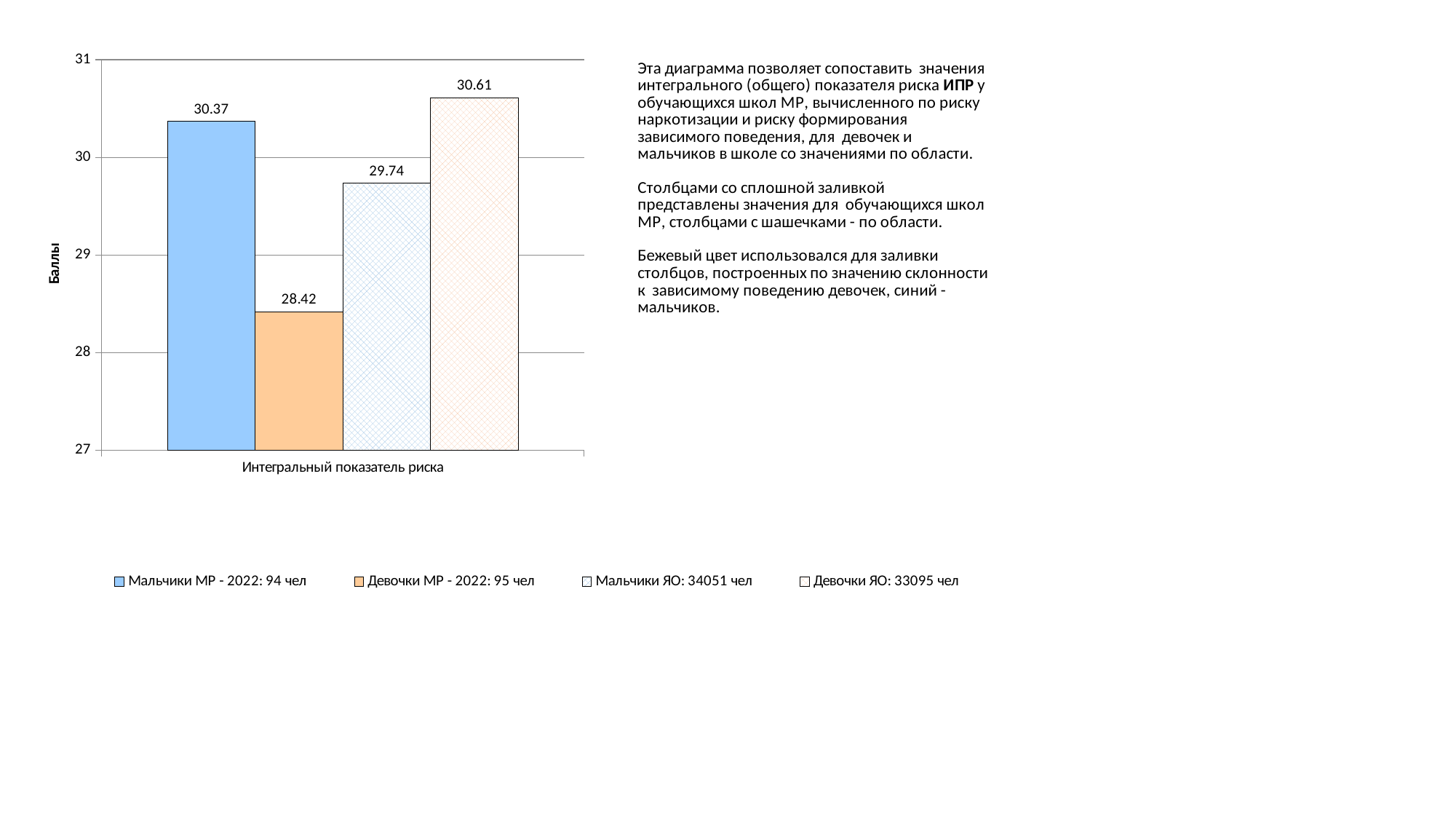
What kind of chart is shown on the slide? bar chart Which series has the highest value? Девочки ЯО: 33095 чел How many series does the legend list? 4 What is the value for Девочки ЯО: 33095 чел? 30.61 What is the value for Девочки МР - 2022: 95 чел? 28.42 Is the value for Девочки МР - 2022: 95 чел greater or less than 29? less What is the difference between the values for Девочки ЯО: 33095 чел and Девочки МР - 2022: 95 чел? 2.19 What is the value for Мальчики МР - 2022: 94 чел? 30.37 What is the value for Мальчики ЯО: 34051 чел? 29.74 Which is larger, the value for Мальчики МР - 2022: 94 чел or the value for Мальчики ЯО: 34051 чел? Мальчики МР - 2022: 94 чел Which series has the lowest value? Девочки МР - 2022: 95 чел What is the label of the y axis? Баллы